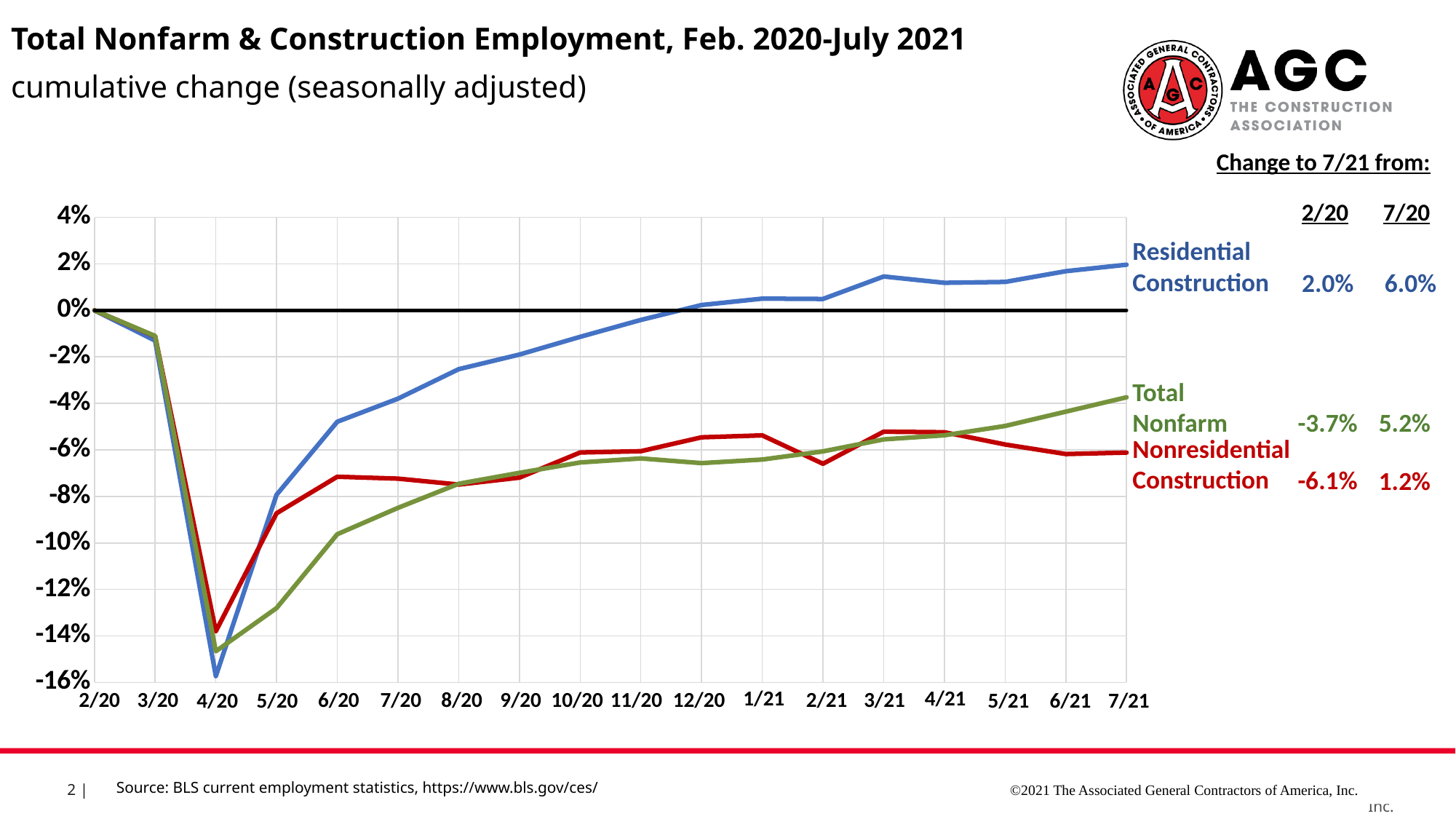
How many months are shown along the x axis of the chart? 18 What is the cumulative change for Nonresidential Construction at 7/21 (change from 2/20)? -6.1% Which series has the lowest value at 4/20? Residential Construction What is the cumulative change for Residential Construction at 7/21 (change from 2/20)? 2.0% What kind of chart is shown on the slide? line chart Is the value for Total Nonfarm at 6/20 greater or less than -8%? less Is the value for Residential Construction at 4/20 greater or less than -14%? less Does the Residential Construction line rise or fall from 4/20 to 7/21? rises What is the cumulative change for Total Nonfarm at 7/21 (change from 2/20)? -3.7% What is the difference between the Residential Construction and Nonresidential Construction values at 7/21? 8.1 percentage points Which series has the highest value at 7/21? Residential Construction How many series are plotted on the chart? 3